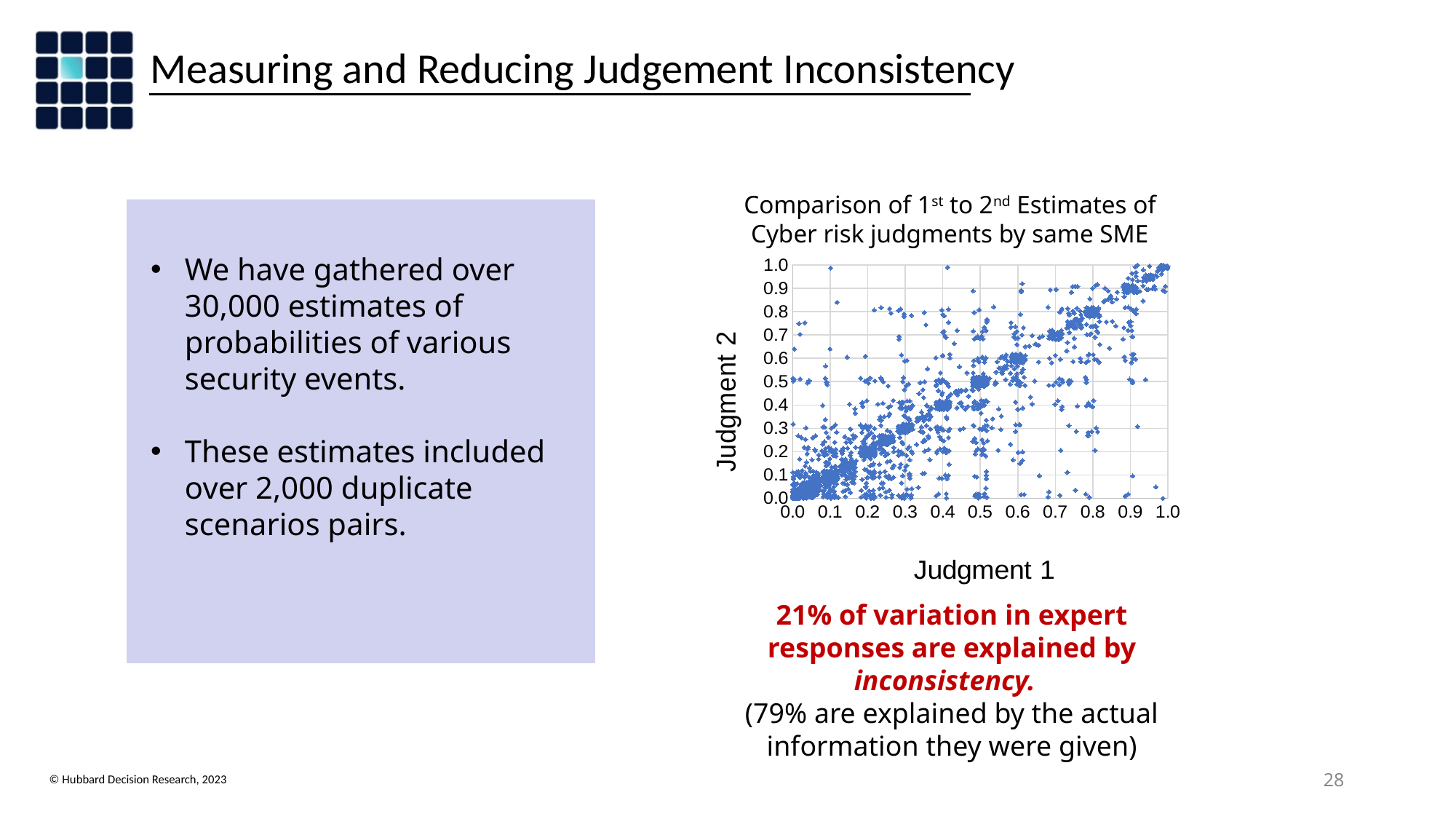
What kind of chart is shown on the slide? Scatter plot What is the label of the y axis of the chart? Judgment 2 In the chart, do the Judgment 2 values generally rise or fall as Judgment 1 increases along the x axis? Rise What is the label of the x axis of the chart? Judgment 1